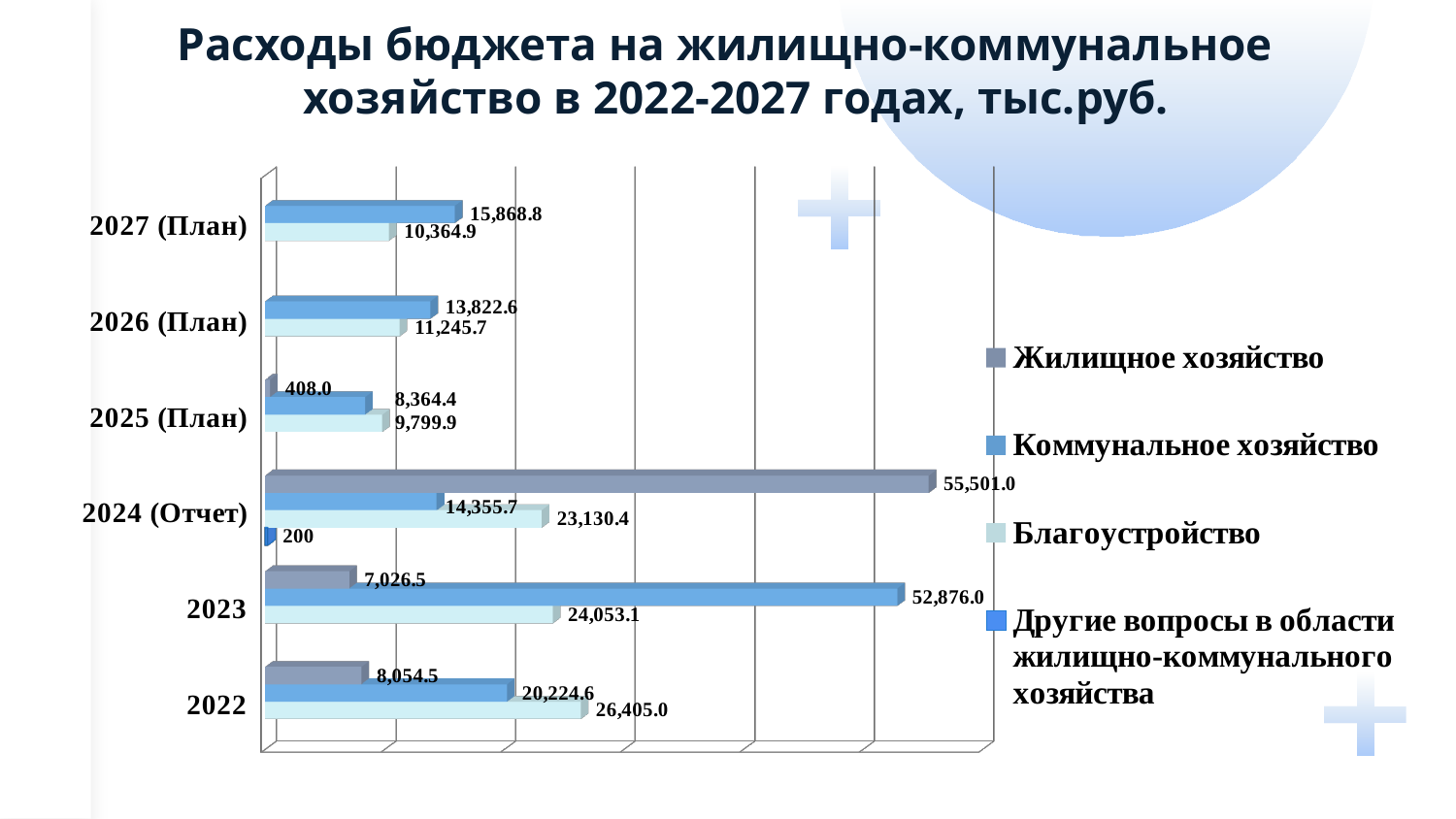
In which year is the value for Коммунальное хозяйство the lowest? 2025 (План) How many series does the legend list? 4 In which year is the value for Благоустройство the highest? 2022 Which is larger: Жилищное хозяйство in 2024 (Отчет) or Коммунальное хозяйство in 2023? Жилищное хозяйство in 2024 (Отчет) What is the value for Благоустройство in 2022? 26,405.0 What is the value for Коммунальное хозяйство in 2023? 52,876.0 What kind of chart is shown on the slide? Bar chart How many year categories are shown on the chart? 6 What is the value for Жилищное хозяйство in 2024 (Отчет)? 55,501.0 Does the value for Коммунальное хозяйство rise or fall from 2025 (План) to 2027 (План)? Rise What is the difference between the Коммунальное хозяйство values for 2027 (План) and 2026 (План)? 2,046.2 What is the value for Другие вопросы в области жилищно-коммунального хозяйства in 2024 (Отчет)? 200